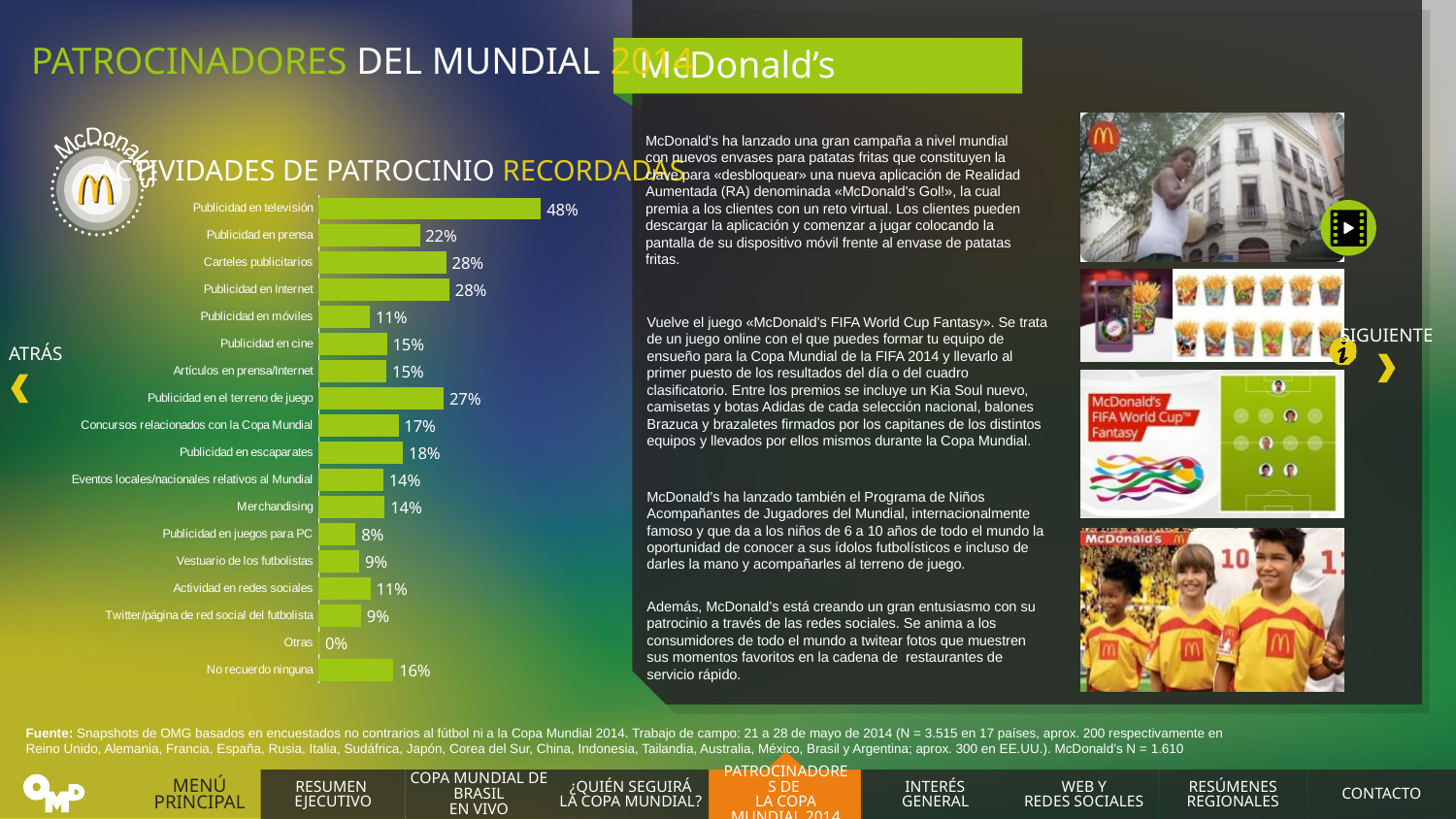
What kind of chart is shown on the slide? Bar chart Which category has the lowest value? Otras Which category has the highest value? Publicidad en televisión What is the value for No recuerdo ninguna? 16% What is the value for Publicidad en el terreno de juego? 27% What is the value for Publicidad en televisión? 48% Which is larger, Publicidad en escaparates or Merchandising? Publicidad en escaparates Which is larger, Publicidad en juegos para PC or Actividad en redes sociales? Actividad en redes sociales What is the difference between Publicidad en televisión and Publicidad en prensa? 26% How many categories are shown in the chart? 18 What is the difference between Publicidad en Internet and Publicidad en móviles? 17% What is the value for Concursos relacionados con la Copa Mundial? 17%